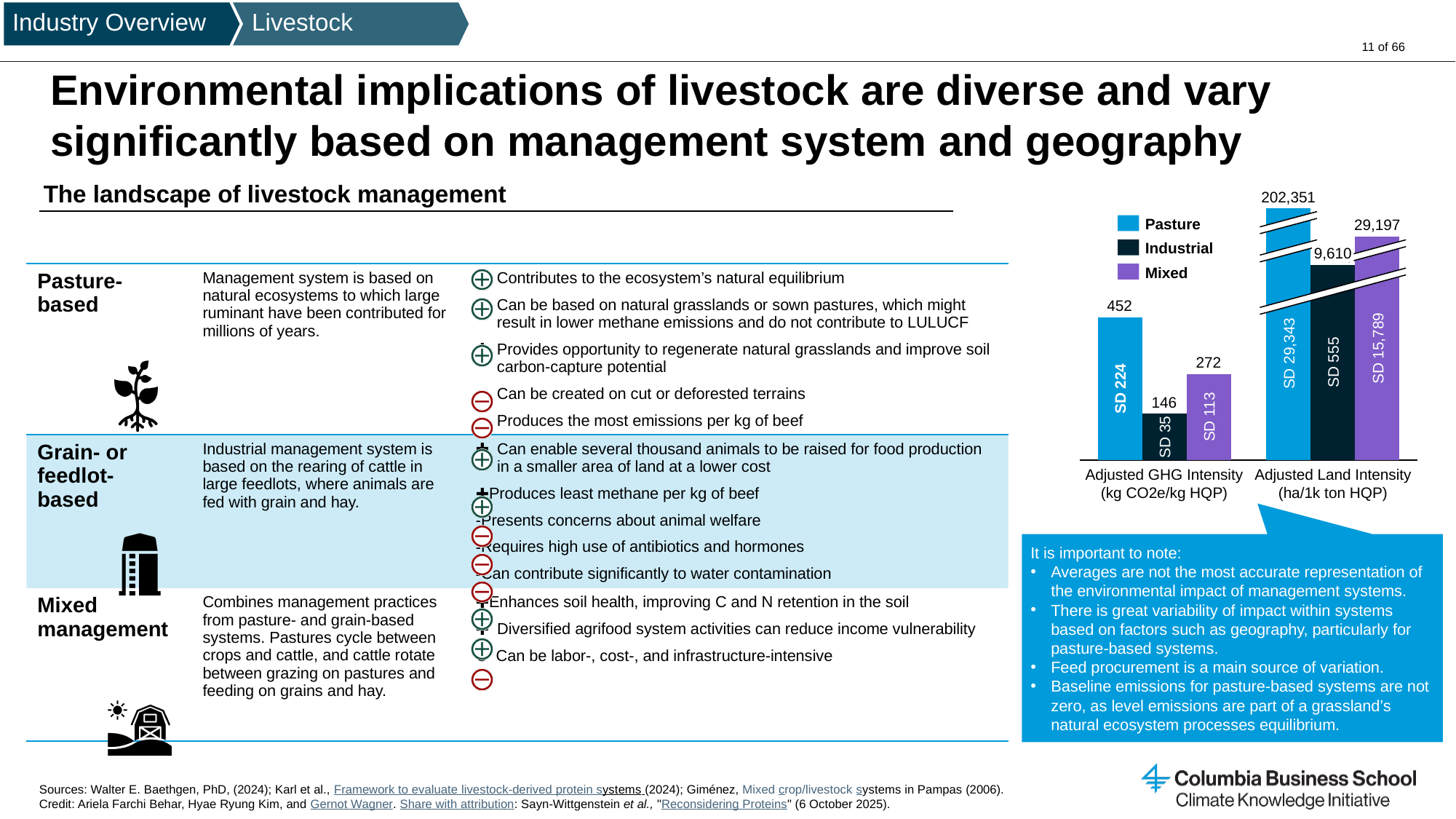
Which series has the highest Adjusted Land Intensity? Pasture What kind of chart is shown on the slide? Bar chart What is the difference between the Mixed and Industrial values for Adjusted Land Intensity? 19,587 What is the Adjusted Land Intensity value for the Mixed series? 29,197 What is the difference between the Pasture and Industrial values for Adjusted GHG Intensity? 306 What is the Adjusted GHG Intensity value for the Pasture series? 452 Which is larger for Adjusted GHG Intensity, the Mixed value or the Industrial value? Mixed Which series has the lowest Adjusted GHG Intensity? Industrial What standard deviation is printed on the Pasture bar for Adjusted Land Intensity? SD 29,343 What is the Adjusted Land Intensity value for the Industrial series? 9,610 How many series does the chart legend list? 3 What is the Adjusted GHG Intensity value for the Mixed series? 272